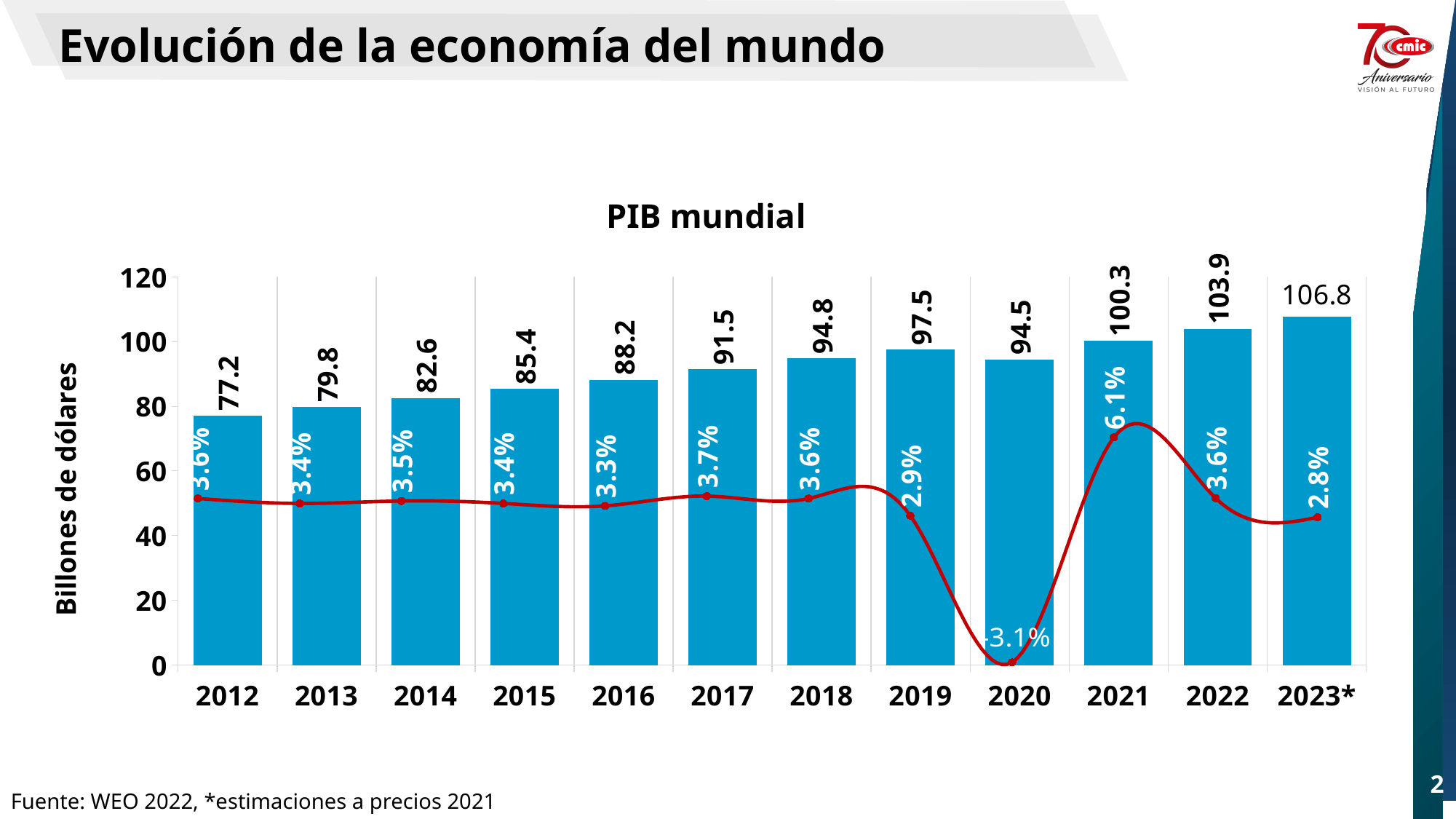
What is the title of the chart? PIB mundial What is the value of the bar for 2023*? 106.8 Which is larger, the bar value for 2019 or for 2020? 2019 What growth percentage is shown on the line for 2021? 6.1% What is the value of the bar for 2012? 77.2 Which year has the lowest bar value? 2012 How many years are shown on the x axis? 12 Which year has the highest bar value? 2023* What is the difference between the bar values for 2022 and 2021? 3.6 What is the label of the vertical axis? Billones de dólares What growth percentage is shown on the line for 2020? -3.1% What kind of chart is this? Bar chart with a line